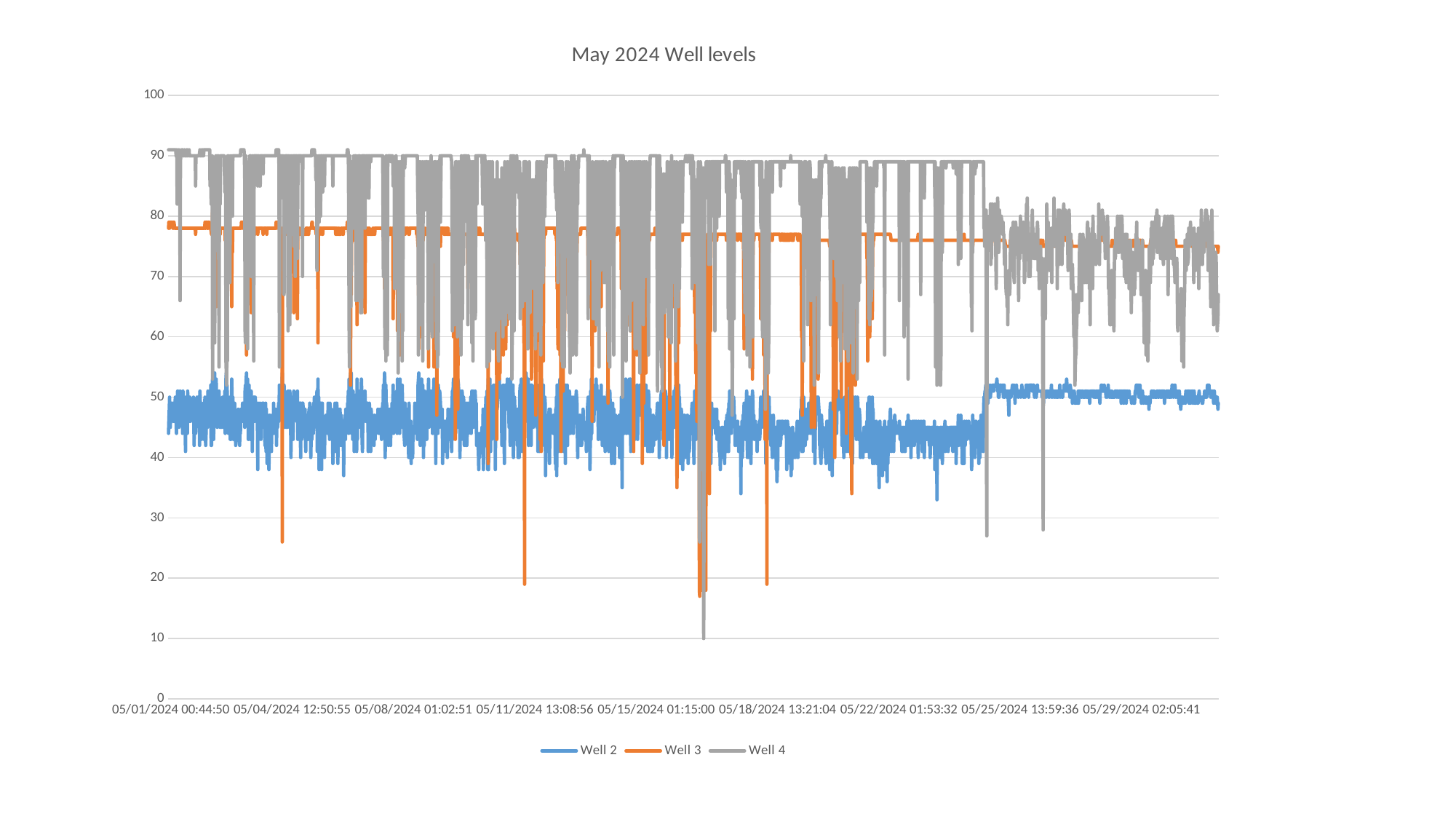
Is the value for Well 4 at the start of the month greater or less than 80? greater Which series generally has the highest values across the chart? Well 4 How many series does the legend list? 3 What kind of chart is shown on the slide? line chart What is the title of the chart? May 2024 Well levels Does the Well 4 level generally rise or fall over the course of the month? fall At the end of the chart, which is higher: Well 3 or Well 2? Well 3 Which colour is used for the Well 4 series? grey Which series generally has the lowest values across the chart? Well 2 Is the value for Well 2 at the start of the month greater or less than 60? less What is the highest value shown on the vertical axis? 100 Is the typical level of Well 3 greater or less than 70? greater